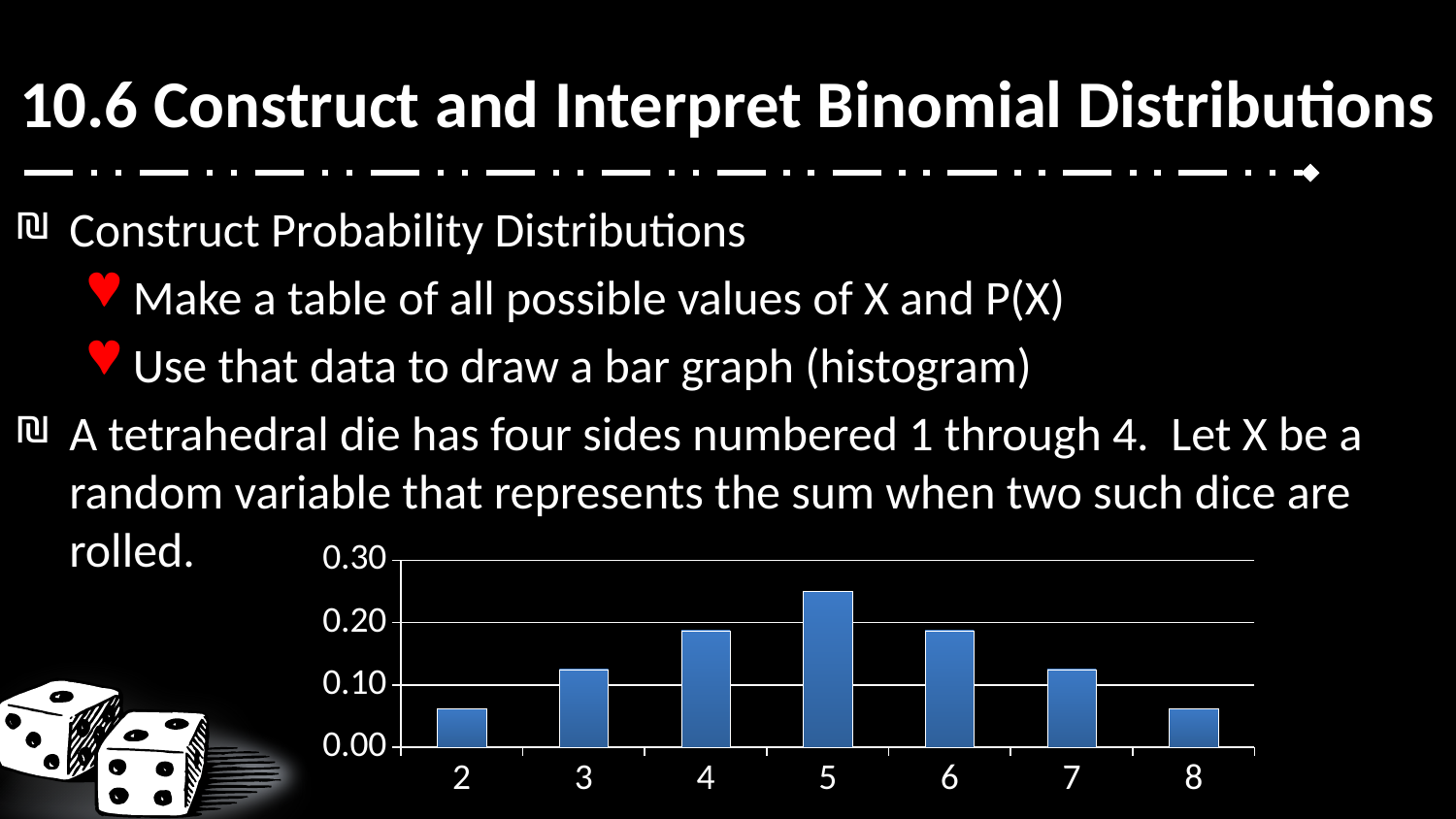
Is the value for category 6 greater or less than 0.10? greater Is the value for category 5 greater or less than 0.20? greater What kind of chart is shown on the slide? bar chart Is the value for category 2 greater or less than 0.10? less How many categories are plotted along the x axis of the chart? 7 Which has the larger value, category 5 or category 2? 5 What is the highest value shown on the y axis of the chart? 0.30 Which has the larger value, category 4 or category 3? 4 How do the values change as the x axis goes from 2 to 8? rise to a peak at 5, then fall Which category has the highest bar in the chart? 5